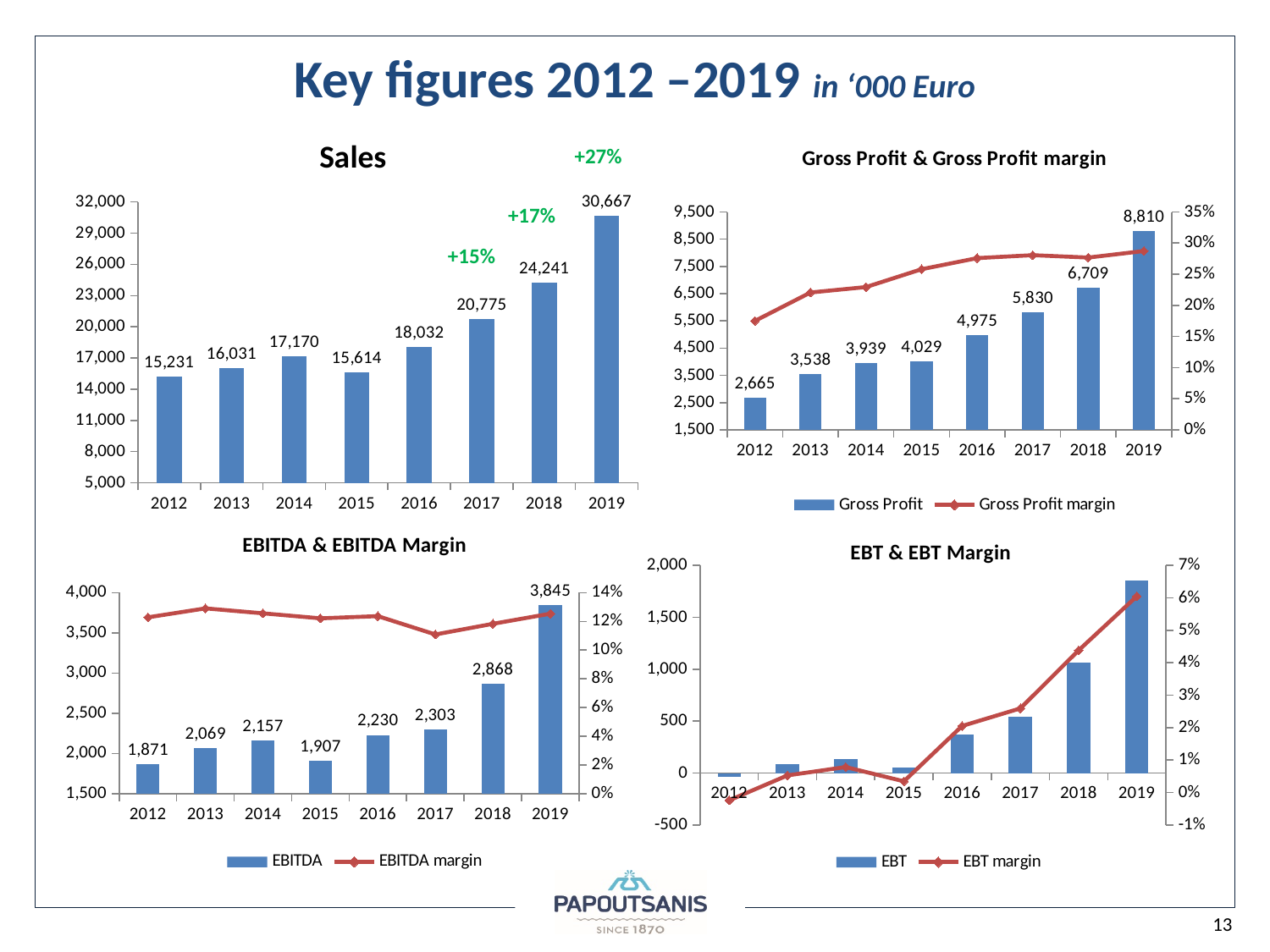
In the Gross Profit & Gross Profit margin chart, which year has the highest Gross Profit? 2019 In the Gross Profit & Gross Profit margin chart, does Gross Profit rise or fall from 2012 to 2019? rise In the Gross Profit & Gross Profit margin chart, what is the Gross Profit for 2016? 4,975 In the EBITDA & EBITDA Margin chart, what is the EBITDA for 2015? 1,907 In the Sales chart, what is the value for 2019? 30,667 In the Sales chart, what is the difference between the 2019 and 2018 values? 6,426 In the Sales chart, which year has the lowest sales? 2012 In the Sales chart, what percentage growth is shown above the 2019 bar? +27% In the EBT & EBT Margin chart, is the EBT value for 2019 greater or less than 1,500? greater In the EBITDA & EBITDA Margin chart, what is the difference between EBITDA in 2019 and 2018? 977 In the EBITDA & EBITDA Margin chart, which is larger, EBITDA in 2014 or in 2015? 2014 How many series does the legend of the EBT & EBT Margin chart list? 2